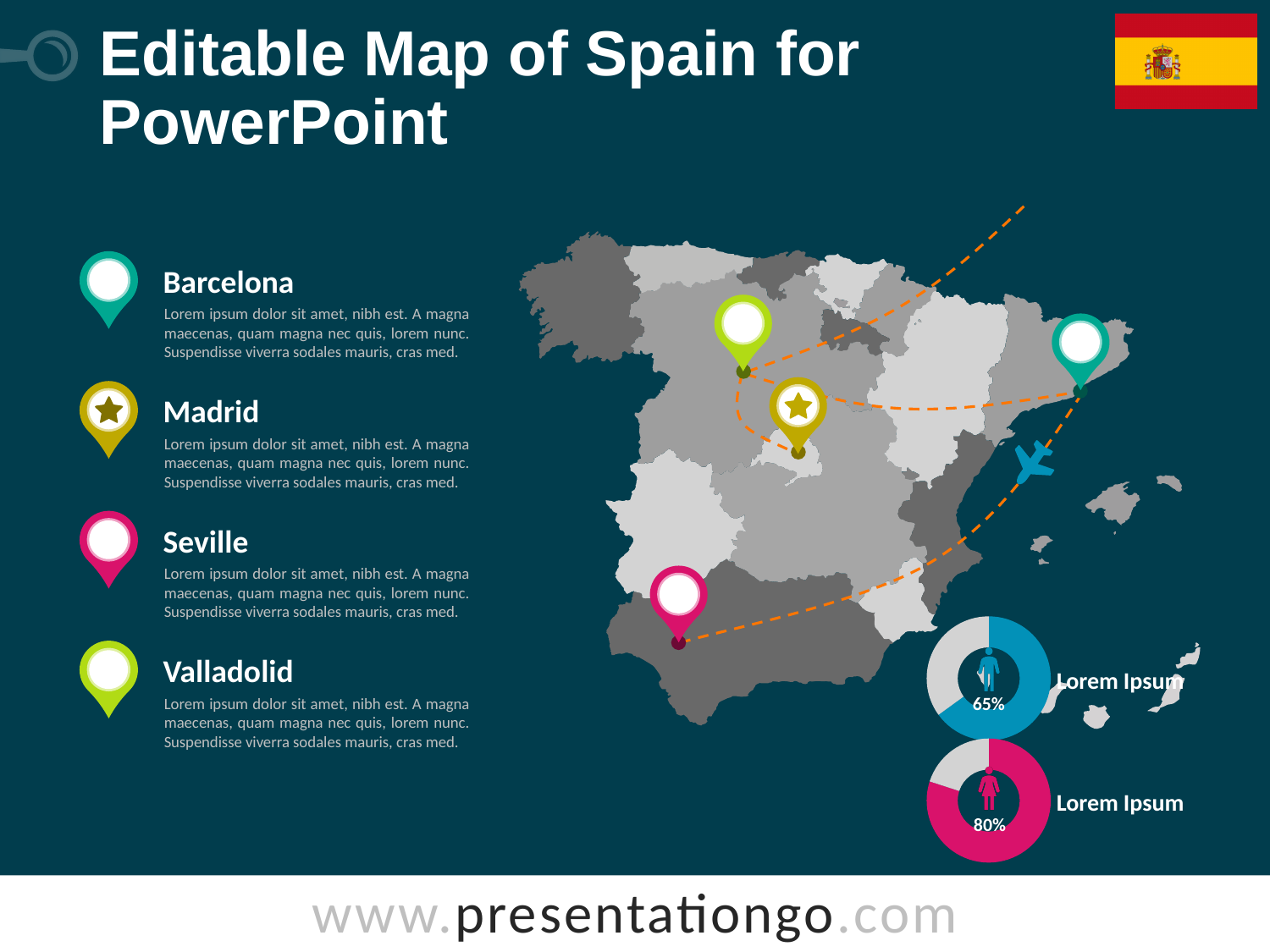
What percentage is shown in the upper (blue) donut chart? 65% Which donut chart shows the smaller value, the upper one or the lower one? the upper one (65%) Which of the two donut charts shows the larger value, the blue one or the pink one? the pink one (80%) In the lower donut chart, what share of the ring is left unfilled (grey)? 20% What kind of chart are the two small circular charts at the bottom right of the map? donut chart What text label is placed next to each of the two donut charts? Lorem Ipsum How many donut charts are on the slide? 2 What percentage is shown in the lower (pink) donut chart? 80% What is the difference between the value in the pink donut chart and the value in the blue donut chart? 15% In the upper donut chart, what share of the ring is filled in blue? 65% What colour is the filled portion of the donut chart showing 80%? pink